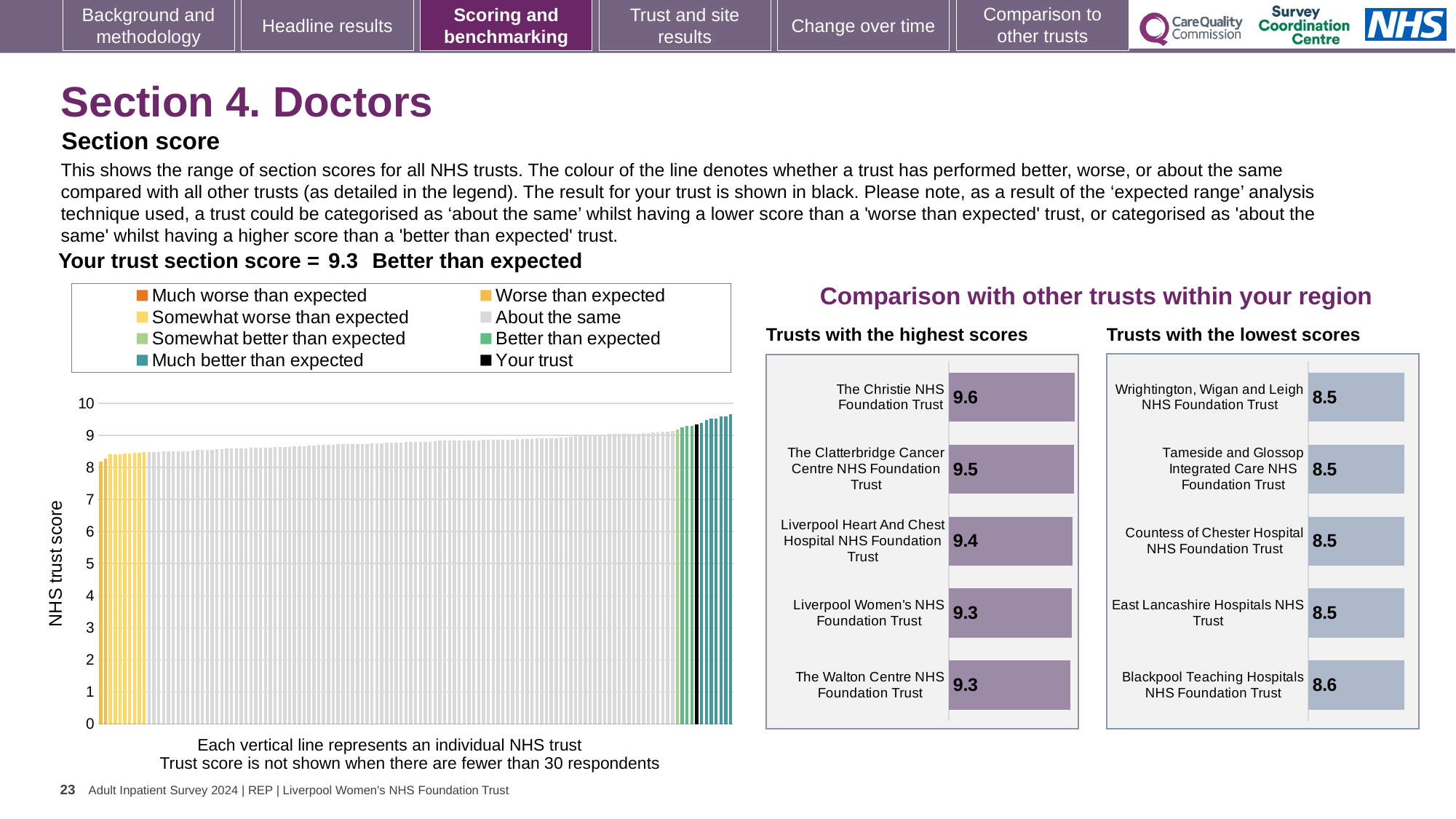
In the 'Trusts with the lowest scores' chart, what is the score for Blackpool Teaching Hospitals NHS Foundation Trust? 8.6 In the 'Trusts with the lowest scores' chart, what is the difference between the scores of Blackpool Teaching Hospitals NHS Foundation Trust and Wrightington, Wigan and Leigh NHS Foundation Trust? 0.1 In the 'Trusts with the highest scores' chart, which has the larger score: The Clatterbridge Cancer Centre NHS Foundation Trust or Liverpool Women's NHS Foundation Trust? The Clatterbridge Cancer Centre NHS Foundation Trust In the 'Trusts with the highest scores' chart, what is the score for The Christie NHS Foundation Trust? 9.6 In the 'Trusts with the highest scores' chart, what is the difference between the scores of The Christie NHS Foundation Trust and The Walton Centre NHS Foundation Trust? 0.3 How many trusts are shown in the 'Trusts with the lowest scores' chart? 5 What kind of chart is the 'Trusts with the highest scores' chart? Bar chart In the 'Trusts with the lowest scores' chart, which trust has the highest score? Blackpool Teaching Hospitals NHS Foundation Trust In the 'Trusts with the highest scores' chart, what is the score for Liverpool Heart And Chest Hospital NHS Foundation Trust? 9.4 In the 'Trusts with the highest scores' chart, which trust has the highest score? The Christie NHS Foundation Trust What is the y-axis label of the large chart on the left showing all NHS trusts? NHS trust score How many trusts are shown in the 'Trusts with the highest scores' chart? 5